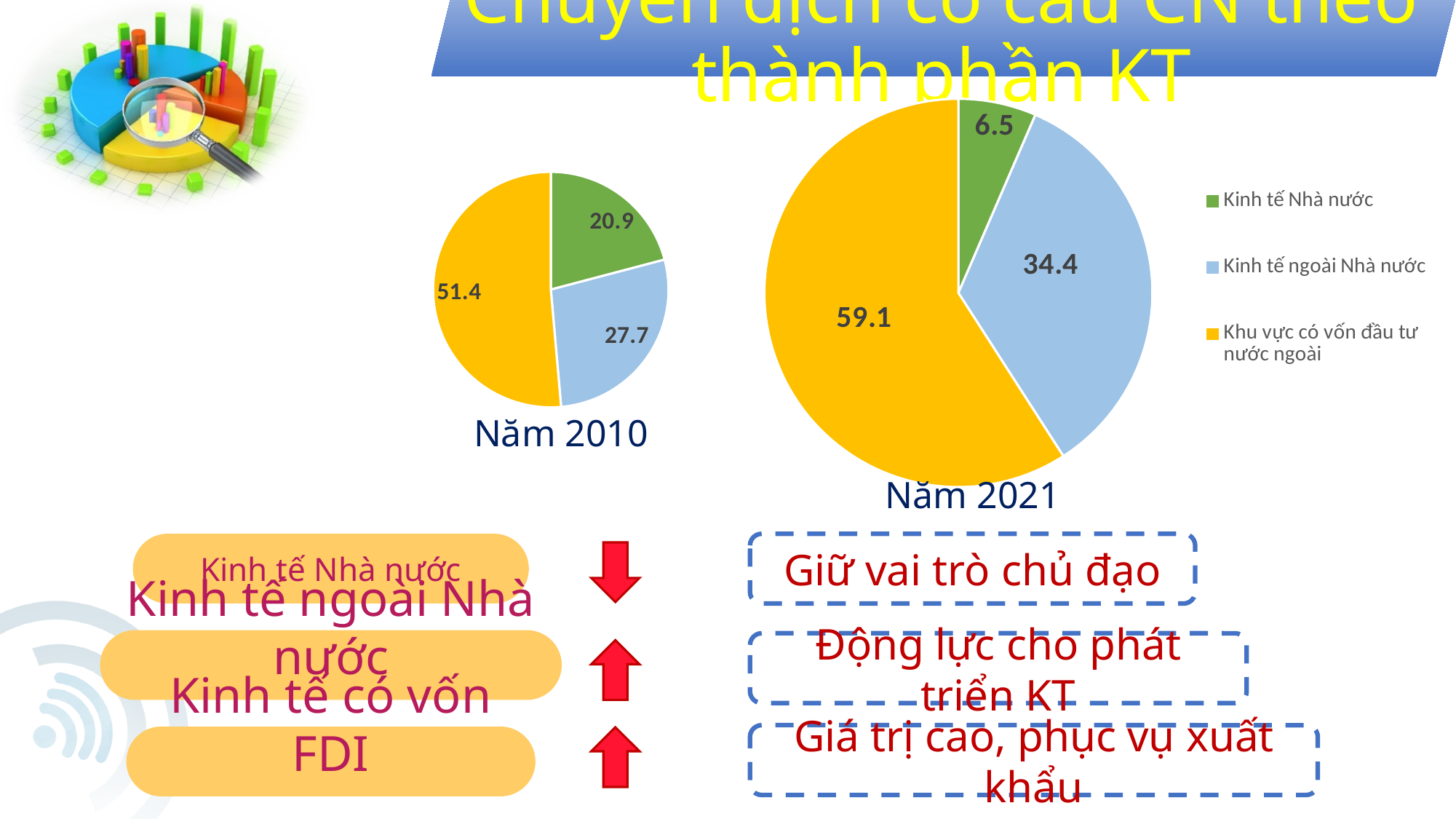
What type of chart is used for "Năm 2021"? Pie chart In the "Năm 2021" pie chart, what is the value for Khu vực có vốn đầu tư nước ngoài? 59.1 Which colour represents Kinh tế ngoài Nhà nước in the legend? Light blue In the "Năm 2021" pie chart, what is the value for Kinh tế Nhà nước? 6.5 What is the difference between the Kinh tế Nhà nước value in the "Năm 2010" chart and in the "Năm 2021" chart? 14.4 How many slices does the "Năm 2010" pie chart have? 3 In the "Năm 2010" pie chart, which category has the largest slice? Khu vực có vốn đầu tư nước ngoài In the "Năm 2010" pie chart, what is the value for Kinh tế Nhà nước? 20.9 In the "Năm 2010" pie chart, what is the value for Kinh tế ngoài Nhà nước? 27.7 In the "Năm 2021" pie chart, what is the difference between Khu vực có vốn đầu tư nước ngoài and Kinh tế ngoài Nhà nước? 24.7 Which is larger: Kinh tế ngoài Nhà nước in the "Năm 2010" chart or in the "Năm 2021" chart? Năm 2021 In the "Năm 2021" pie chart, which category has the smallest slice? Kinh tế Nhà nước